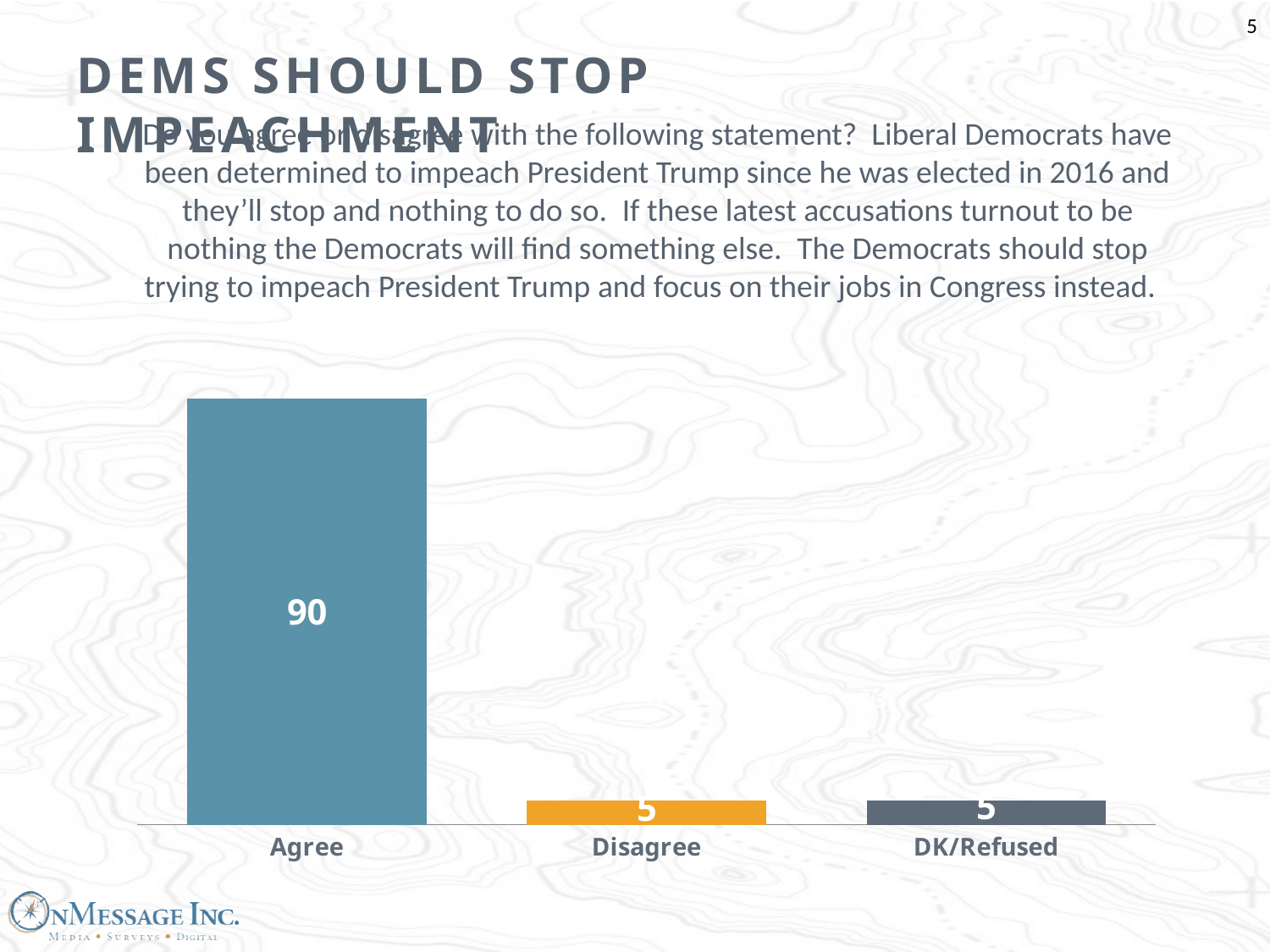
What is the difference between the values for Agree and Disagree? 85 What is the value for Agree? 90 What is the value for Disagree? 5 Which is larger, the value for Agree or the value for DK/Refused? Agree What colour is the Agree bar? Blue What colour is the Disagree bar? Orange How many categories are shown on the x axis? 3 What is the value for DK/Refused? 5 Which category has the highest value? Agree What kind of chart is shown on the slide? Bar chart What is the total of the values for Agree, Disagree and DK/Refused? 100